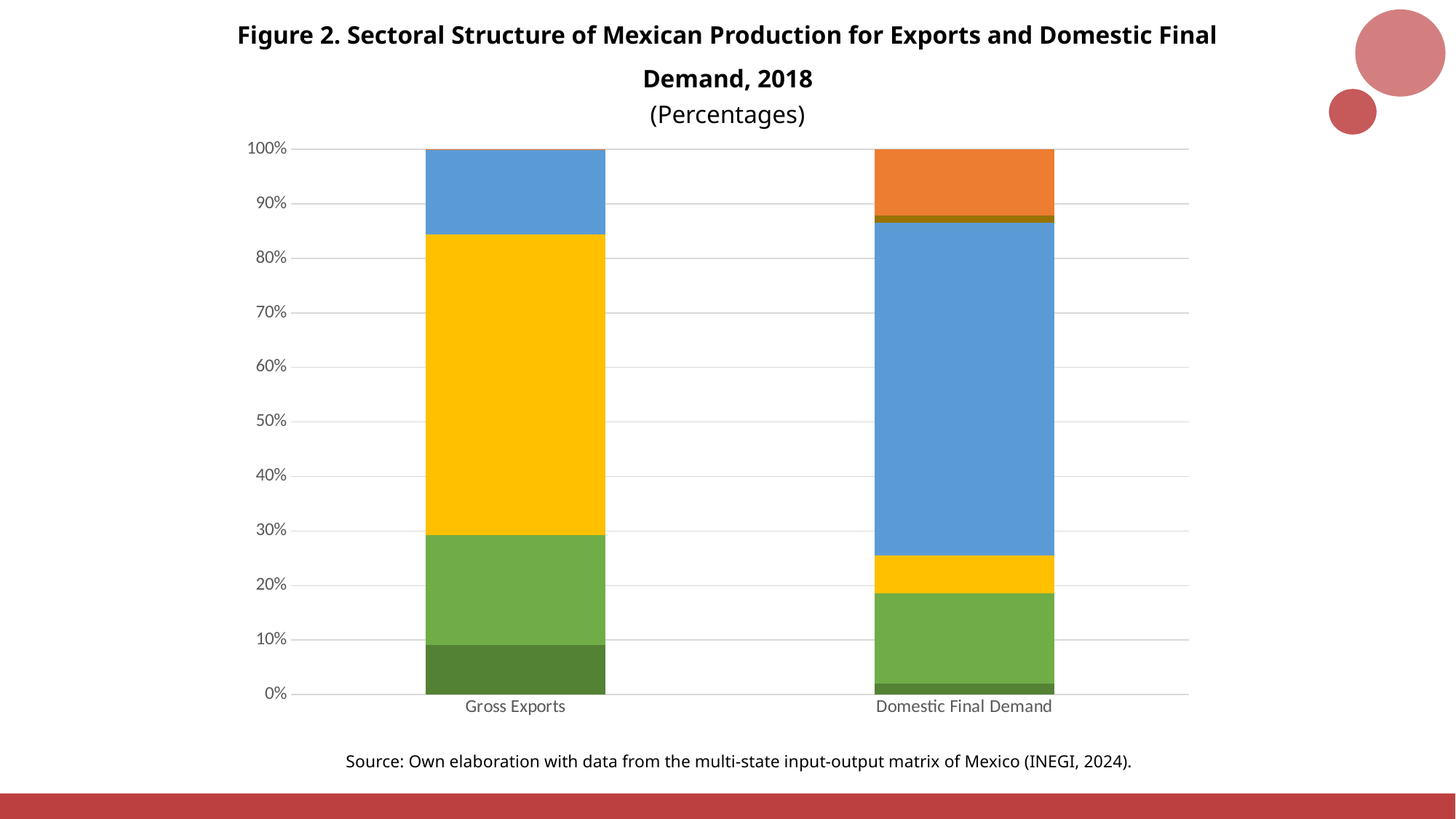
What is the total height of the Gross Exports stacked bar? 100% Which colour segment is the largest in the Gross Exports bar? Yellow How many categories are shown on the x axis? 2 What unit is the chart's y axis expressed in, according to the subtitle? Percentages Which bar has the larger blue segment, Gross Exports or Domestic Final Demand? Domestic Final Demand What kind of chart is shown on the slide? Stacked bar chart Is the value of the dark green segment at the bottom of the Gross Exports bar greater or less than 10%? less Which colour segment is the smallest in the Gross Exports bar? Dark green Which colour segment is the largest in the Domestic Final Demand bar? Blue Is the value of the yellow segment in the Gross Exports bar greater or less than 50%? greater Which bar has the larger yellow segment, Gross Exports or Domestic Final Demand? Gross Exports What is the total height of the Domestic Final Demand stacked bar? 100%